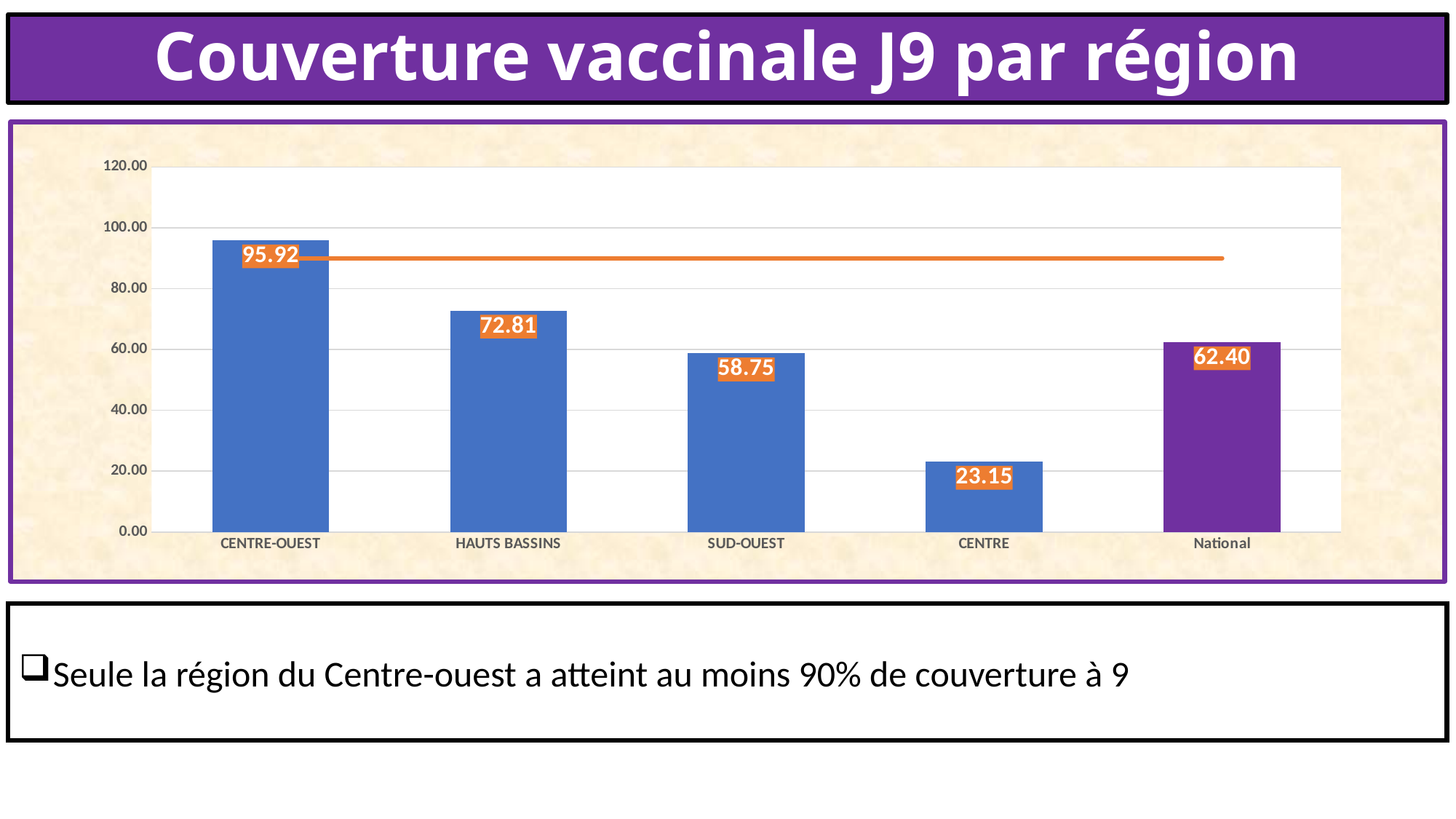
What is the value for National? 62.40 What is the title of the slide? Couverture vaccinale J9 par région How many categories are shown on the x axis? 5 What kind of chart is shown on the slide? Bar chart What is the value for CENTRE? 23.15 What is the value for CENTRE-OUEST? 95.92 Which category has the highest value? CENTRE-OUEST Which is larger, the value for SUD-OUEST or the value for National? National What is the value for HAUTS BASSINS? 72.81 What is the difference between the values for CENTRE-OUEST and HAUTS BASSINS? 23.11 What is the value for SUD-OUEST? 58.75 Which category has the lowest value? CENTRE